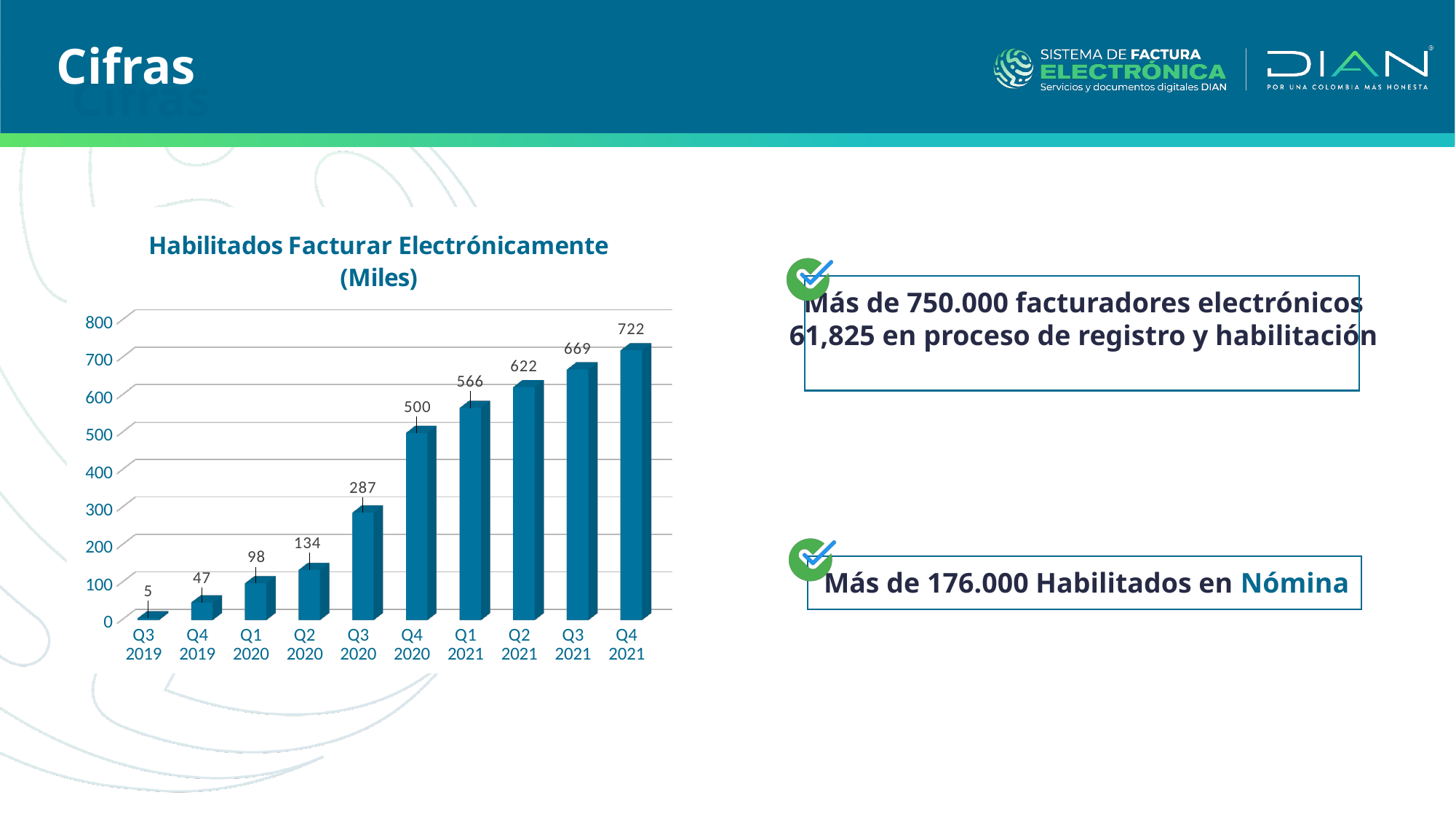
What kind of chart is shown on the slide? Bar chart Do the values rise or fall from Q3 2019 to Q4 2021? Rise What is the value for Q1 2020 in the chart? 98 What is the title of the chart? Habilitados Facturar Electrónicamente (Miles) Which is larger, the value for Q2 2020 or the value for Q4 2019? Q2 2020 What is the value for Q4 2021 in the Habilitados Facturar Electrónicamente chart? 722 Which quarter has the lowest value in the chart? Q3 2019 What is the value for Q3 2020 in the chart? 287 Which quarter has the highest value in the chart? Q4 2021 How many quarters are shown on the x axis of the chart? 10 What is the difference between the values for Q4 2020 and Q3 2020? 213 What is the difference between the values for Q4 2021 and Q3 2021? 53